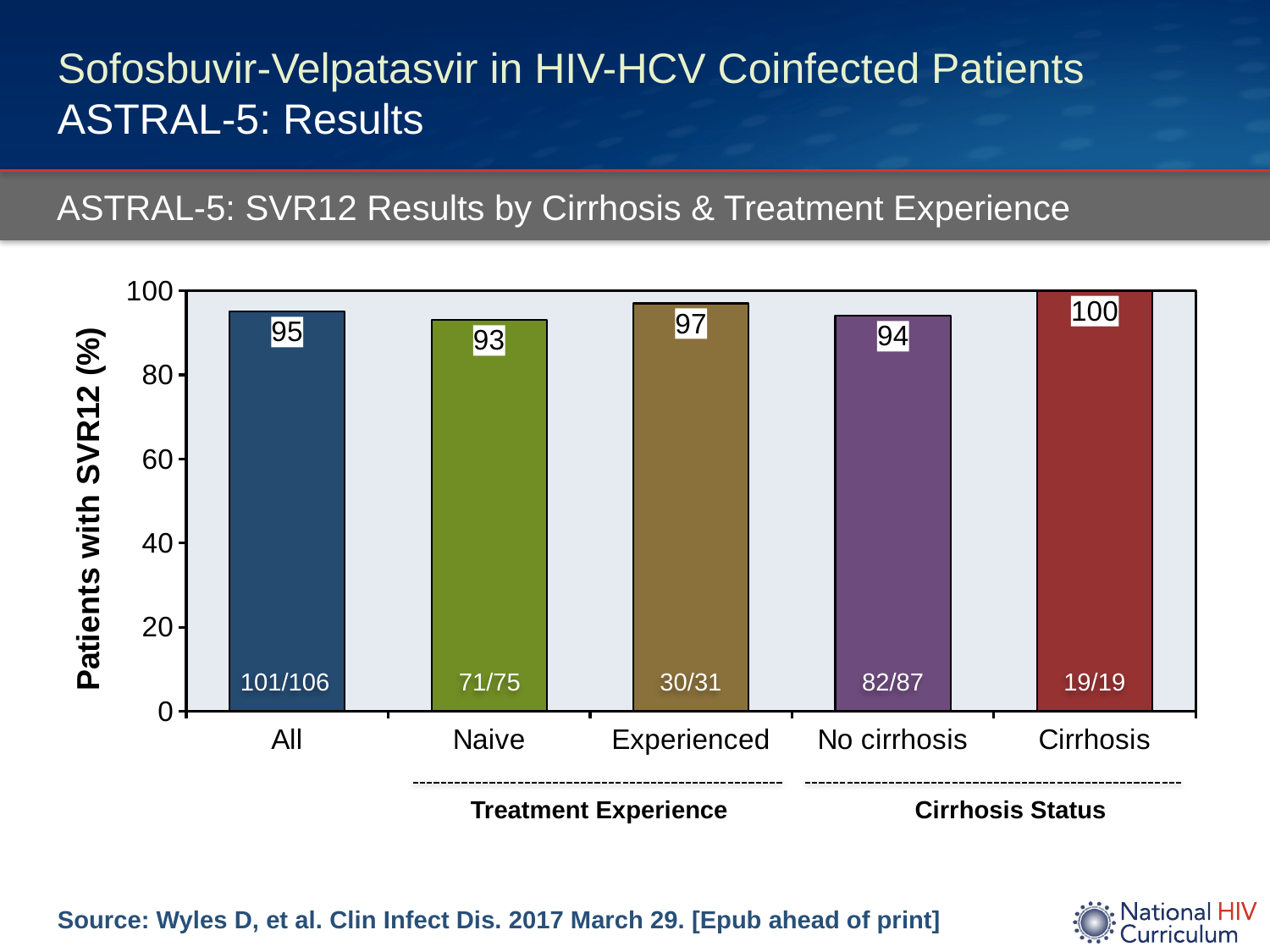
Which category has the highest SVR12 rate? Cirrhosis Which has a higher SVR12 rate, No cirrhosis or Cirrhosis? Cirrhosis How many categories are shown on the x axis? 5 How many patients achieved SVR12 in the Experienced group, as shown at the base of the bar? 30/31 What is the label of the y axis? Patients with SVR12 (%) Which category has the lowest SVR12 rate? Naive What is the SVR12 rate for the Naive group? 93 What is the SVR12 rate for the All group? 95 Is the SVR12 rate for the No cirrhosis group greater or less than 80? greater What is the SVR12 rate for the Cirrhosis group? 100 What is the difference in SVR12 rate between the Experienced and Naive groups? 4 What kind of chart is shown on the slide? Bar chart